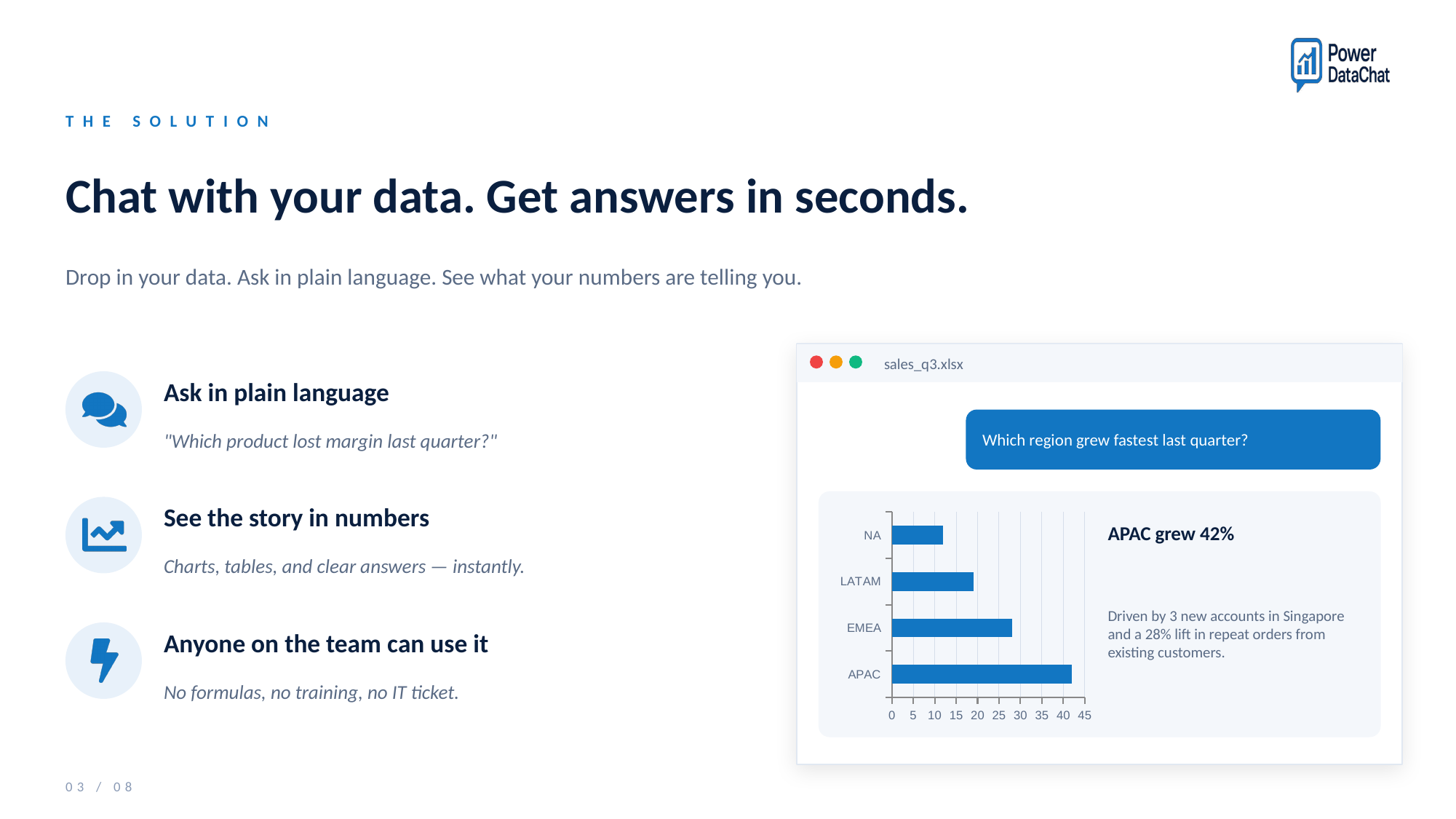
What is the highest tick value shown on the chart's horizontal axis? 45 Which region has the larger value, EMEA or LATAM? EMEA Is the value for APAC greater or less than 40? greater According to the slide, by what percentage did APAC grow? 42% Is the value for EMEA greater or less than 30? less Is the value for NA greater or less than 15? less Which region has the shortest bar in the chart? NA Which region has the longest bar in the chart? APAC How many regions are plotted in the bar chart? 4 What kind of chart is shown in the sales_q3.xlsx window? bar chart